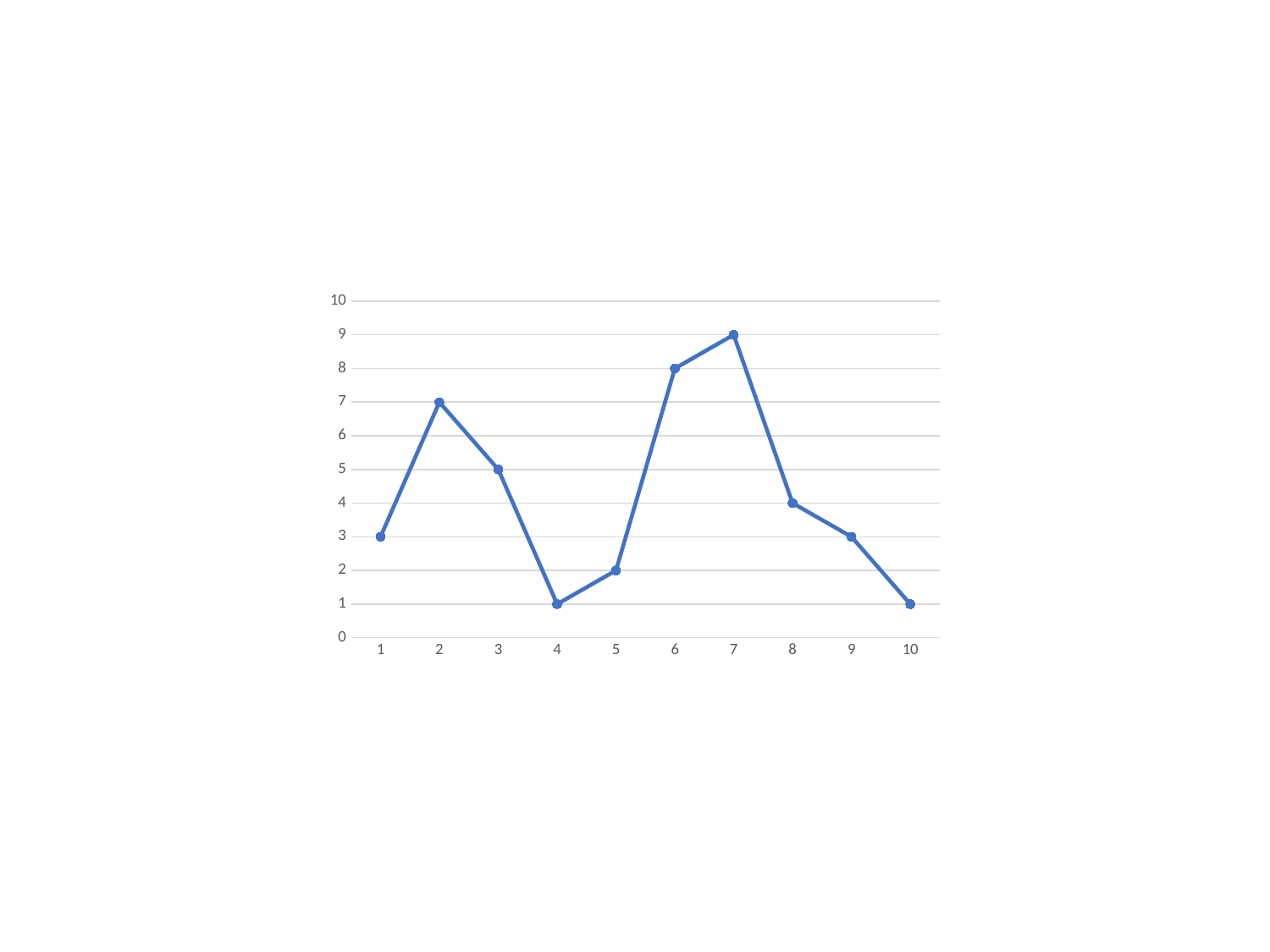
What is the difference between the values at x = 7 and x = 4? 8 Is the value at x = 6 greater or less than 5? greater What is the lowest value plotted on the chart? 1 What is the maximum value shown on the vertical axis? 10 At which x value does the line reach its highest point? 7 How many data points are plotted on the line? 10 What is the value at x = 4? 1 What kind of chart is shown on the slide? line chart What is the value at x = 2? 7 Do the values rise or fall from x = 7 to x = 10? fall Which is larger, the value at x = 3 or the value at x = 8? x = 3 What is the value at x = 7? 9